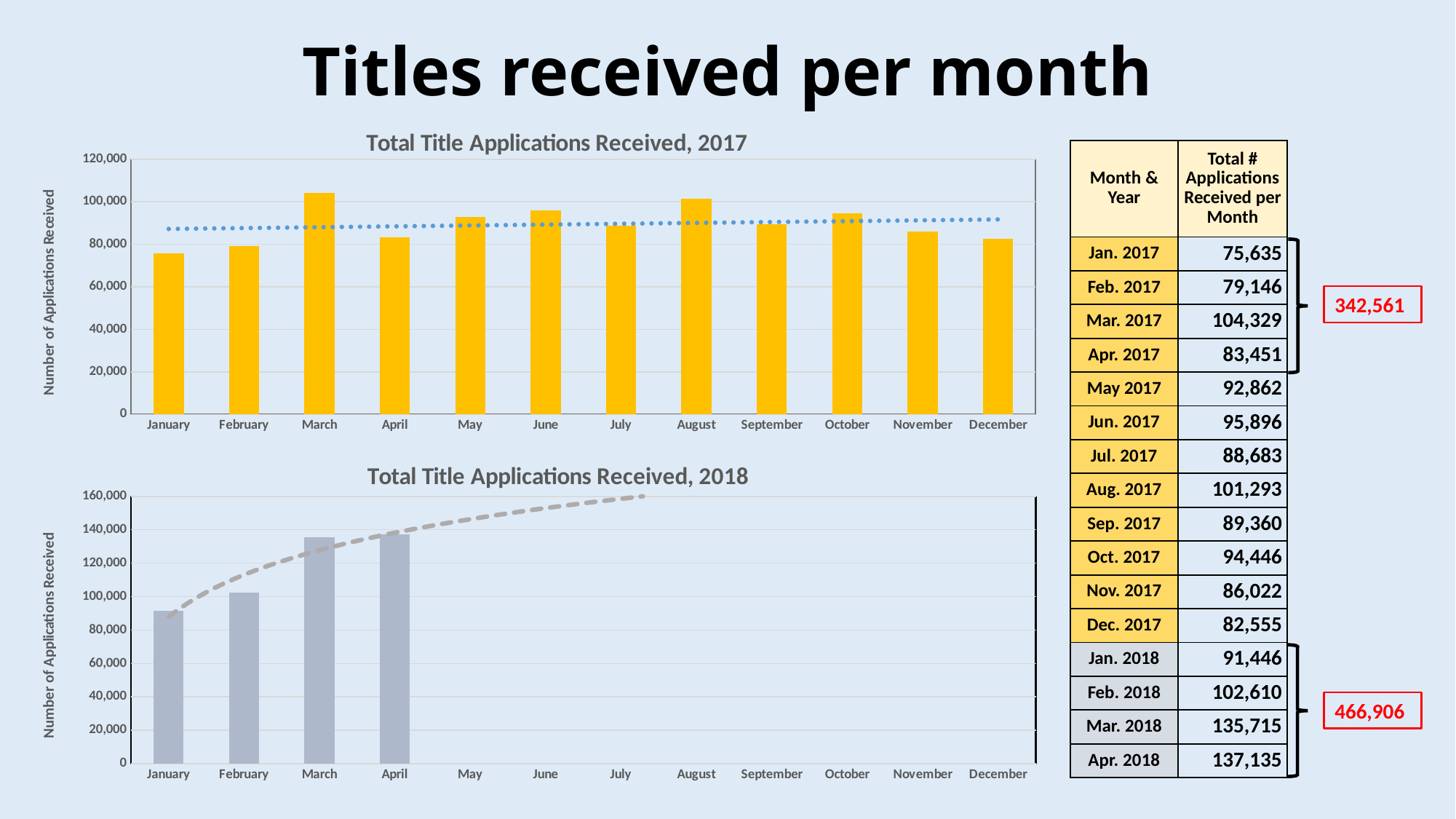
In the 'Total Title Applications Received, 2017' chart, which month has the lowest value? January In the 'Total Title Applications Received, 2017' chart, which is larger, the value for August or the value for September? August What kind of chart is 'Total Title Applications Received, 2018'? Bar chart In the 'Total Title Applications Received, 2018' chart, do the values rise or fall from January to April? Rise In the 'Total Title Applications Received, 2017' chart, is the value for March greater or less than 100,000? greater In the 'Total Title Applications Received, 2018' chart, how many months have bars plotted? 4 In the 'Total Title Applications Received, 2017' chart, which month has the highest value? March What is the y-axis label of the 'Total Title Applications Received, 2017' chart? Number of Applications Received In the 'Total Title Applications Received, 2018' chart, is the value for January greater or less than 100,000? less According to the table on the slide, what is the difference between the Mar. 2017 and Jan. 2017 values? 28,694 According to the table on the slide, how many title applications were received in Mar. 2018? 135,715 In the 'Total Title Applications Received, 2017' chart, how many months have bars plotted? 12